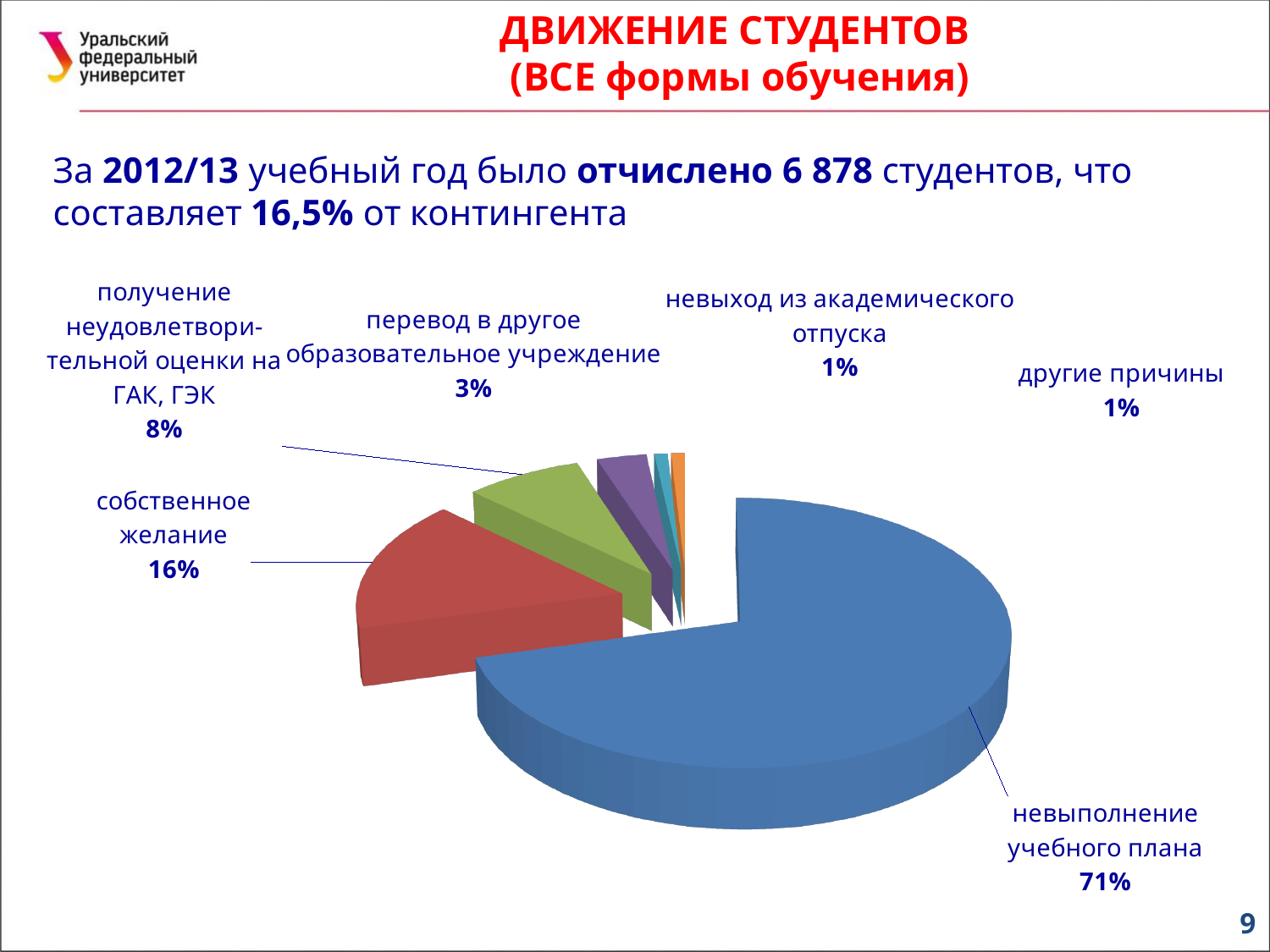
Which category has the largest slice of the pie? невыполнение учебного плана Which is larger: the slice for "собственное желание" or the slice for "перевод в другое образовательное учреждение"? собственное желание What share of the pie is labelled "перевод в другое образовательное учреждение"? 3% What is the difference in percentage points between "невыполнение учебного плана" and "собственное желание"? 55 What is the difference in percentage points between "получение неудовлетворительной оценки на ГАК, ГЭК" and "перевод в другое образовательное учреждение"? 5 What kind of chart is shown on the slide? pie chart What share of the pie is labelled "получение неудовлетворительной оценки на ГАК, ГЭК"? 8% What share of the pie is labelled "невыполнение учебного плана"? 71% What colour is the largest slice of the pie chart? blue How many slices does the pie chart have? 6